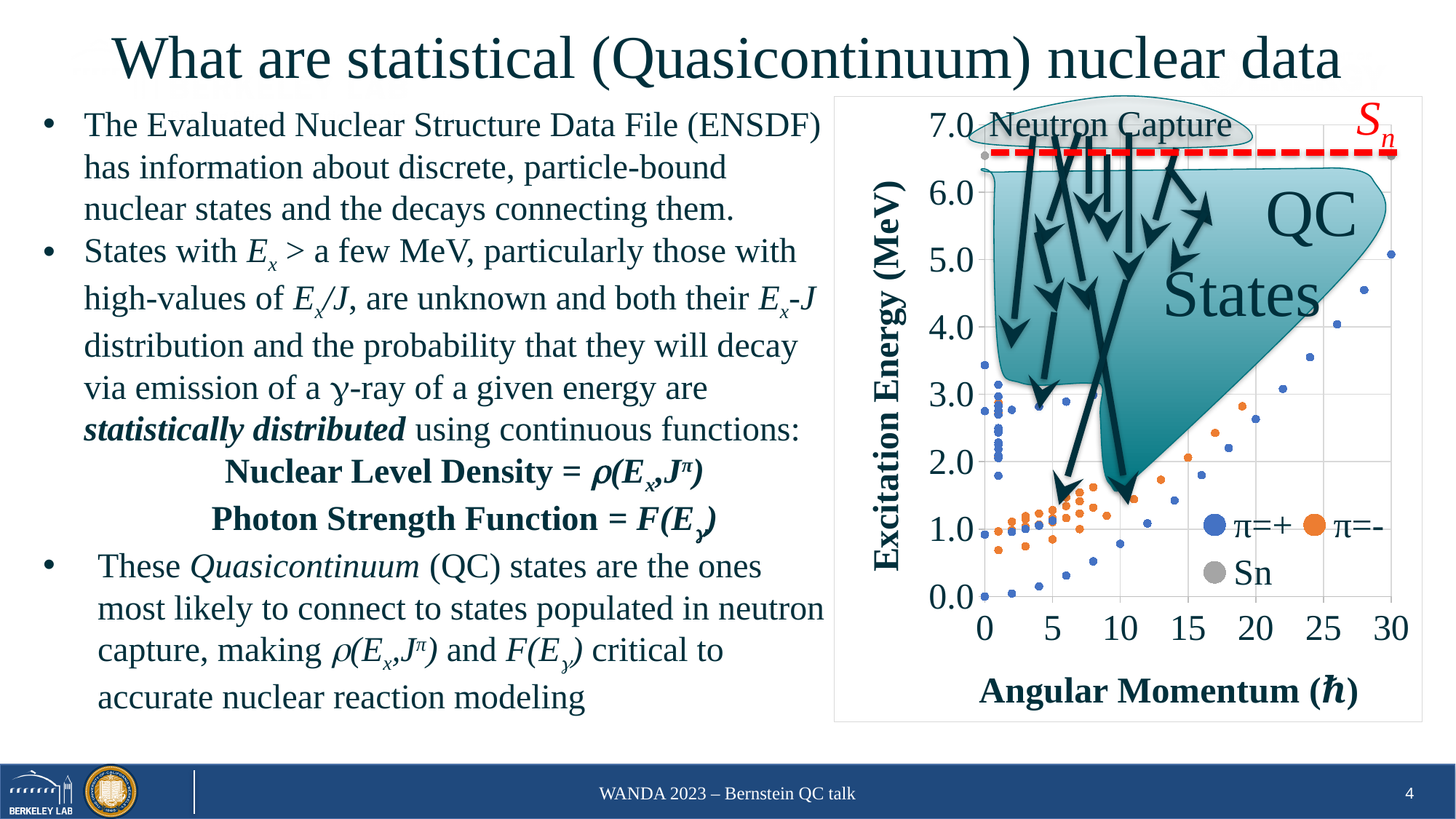
Which series is plotted in orange on the chart? π=- Is the excitation energy of the Sn points greater or less than 7.0 MeV? less What is the highest value shown on the vertical axis of the chart? 7.0 What kind of chart is shown on the slide? scatter chart What are the series names listed in the chart legend? π=+, π=-, Sn Is the excitation energy of the Sn points greater or less than 6.0 MeV? greater How many series does the chart legend list? 3